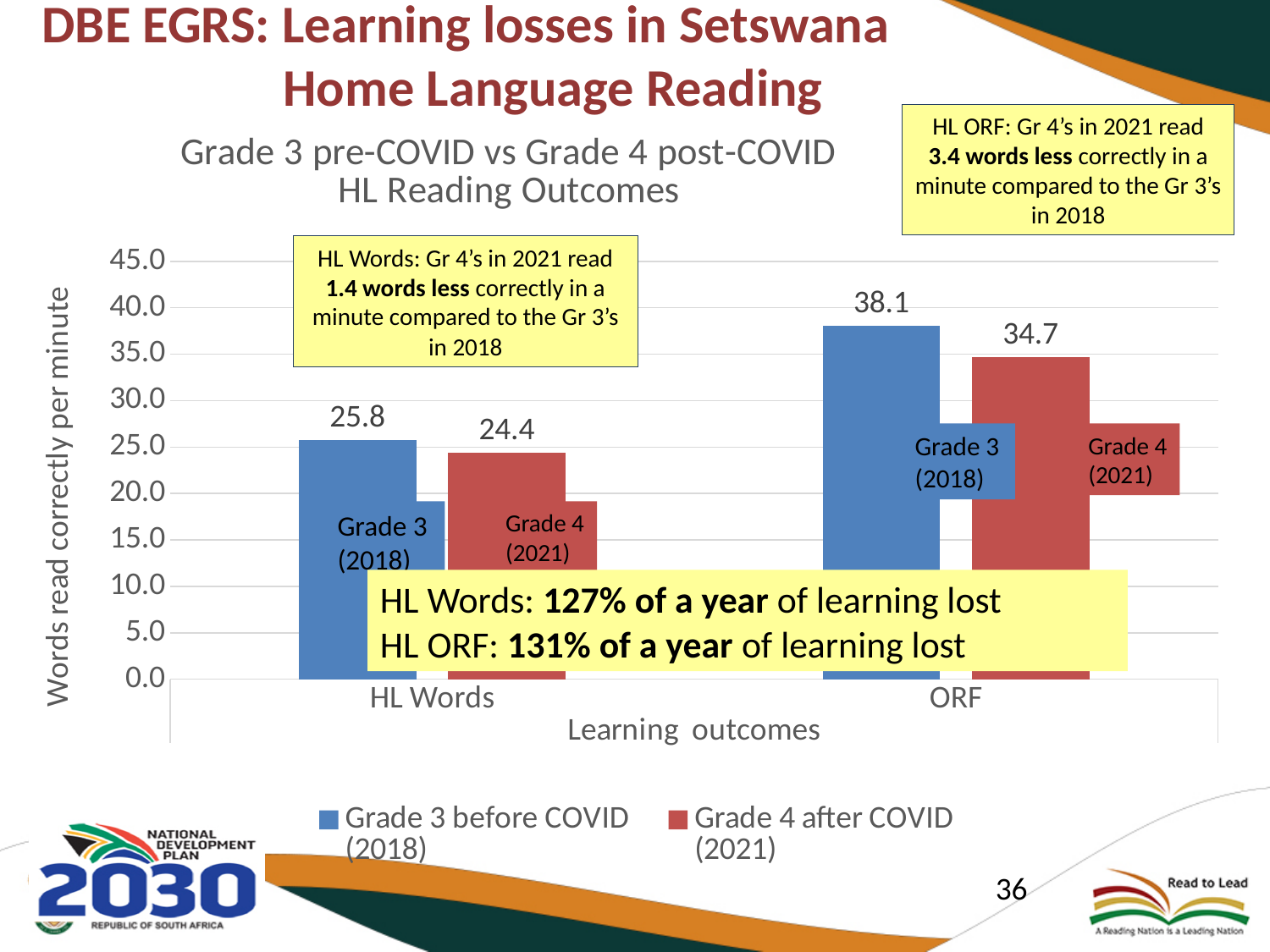
Which bar has the highest value on the chart? Grade 3 before COVID (2018), ORF What is the value for Grade 3 before COVID (2018) in the ORF category? 38.1 What is the difference between the Grade 3 (2018) and Grade 4 (2021) values for HL Words? 1.4 Which bar has the lowest value on the chart? Grade 4 after COVID (2021), HL Words How many series does the legend list? 2 What is the value for Grade 4 after COVID (2021) in the HL Words category? 24.4 How many categories are shown on the x axis? 2 What is the difference between the Grade 3 (2018) and Grade 4 (2021) values for ORF? 3.4 Which is larger for HL Words: Grade 3 before COVID (2018) or Grade 4 after COVID (2021)? Grade 3 before COVID (2018) What is the value for Grade 4 after COVID (2021) in the ORF category? 34.7 What type of chart is shown on the slide? Bar chart What is the value for Grade 3 before COVID (2018) in the HL Words category? 25.8